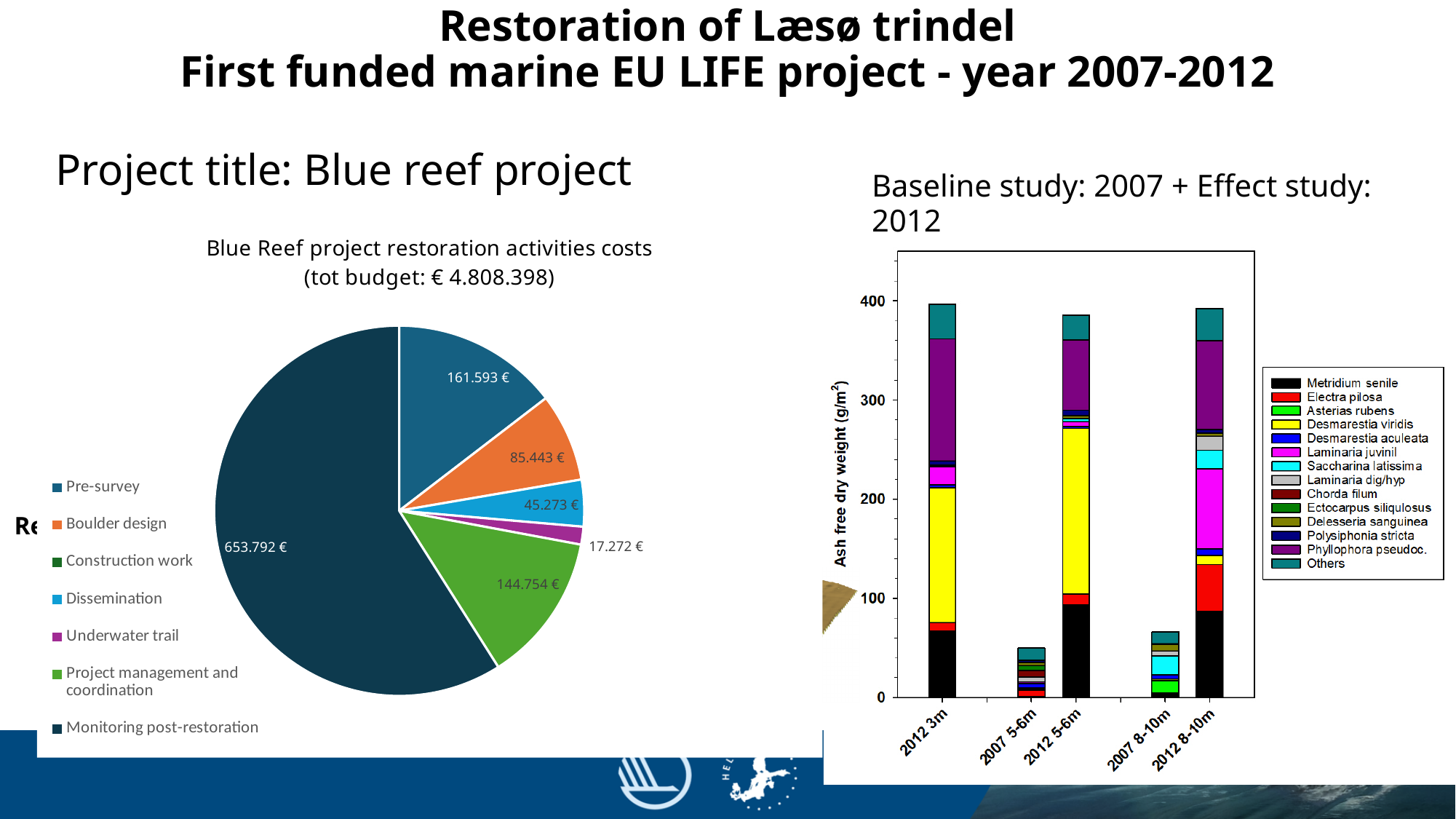
What kind of chart is the chart on the right showing ash free dry weight? Stacked bar chart On the ash free dry weight bar chart, is the total for 2007 5-6m greater or less than 100? less On the pie chart, what is the cost shown for Dissemination? 45.273 € How many categories are shown on the x axis of the ash free dry weight bar chart? 5 On the pie chart, what is the cost shown for Pre-survey? 161.593 € On the pie chart, what is the cost shown for Boulder design? 85.443 € What total budget is stated in the pie chart's title? € 4.808.398 How many series does the legend of the ash free dry weight bar chart list? 14 On the pie chart, which is larger: the cost for Pre-survey or for Boulder design? Pre-survey On the pie chart, what is the cost shown for Project management and coordination? 144.754 € On the pie chart, what is the difference between the Pre-survey cost and the Boulder design cost? 76.150 €